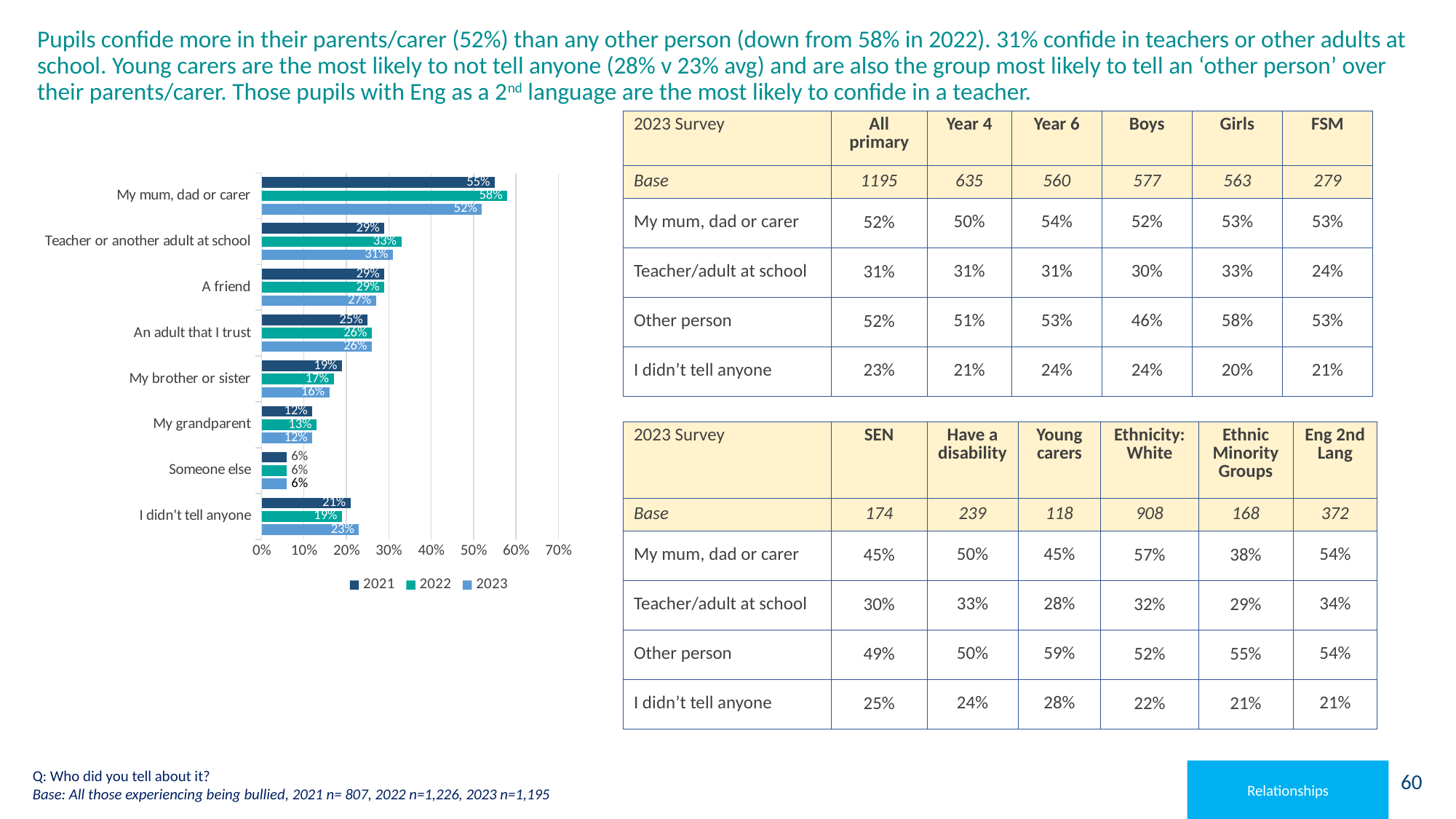
What is the 2021 value for 'I didn't tell anyone' in the chart? 21% Which category has the lowest 2022 value in the chart? Someone else What is the 2022 value for 'Teacher or another adult at school' in the chart? 33% Is the 2022 value for 'My mum, dad or carer' greater or less than 50%? greater Which series in the chart legend is shown in the darkest blue colour? 2021 What is the difference between the 2022 and 2023 values for 'My mum, dad or carer' in the chart? 6% In the chart, which is larger for 'My brother or sister': the 2021 value or the 2023 value? 2021 Which category has the highest 2023 value in the chart? My mum, dad or carer What type of chart is shown on the slide? bar chart How many series does the chart legend list? 3 How many categories are shown on the chart? 8 What is the 2023 value for 'My mum, dad or carer' in the chart? 52%